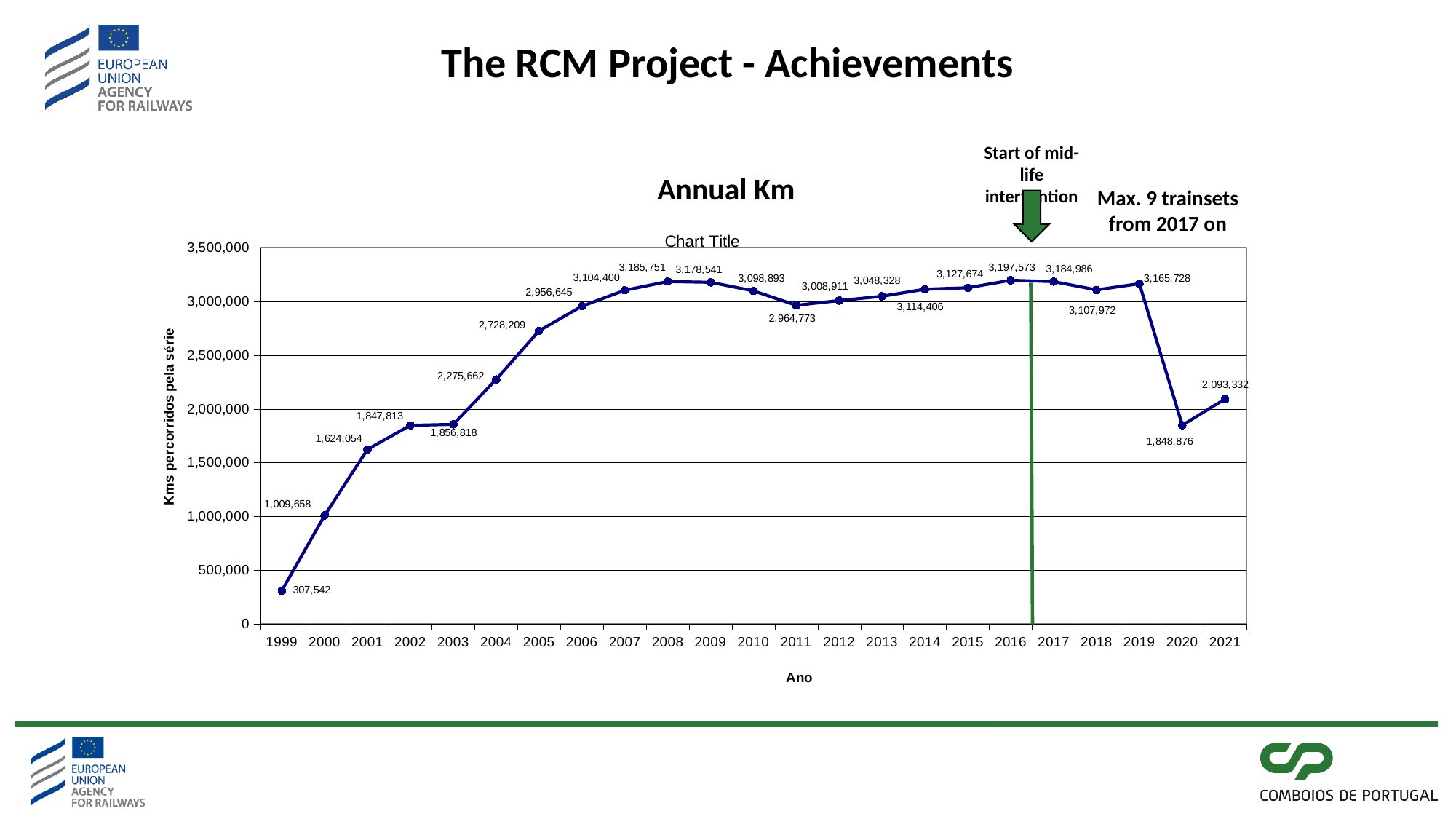
What is the label of the y axis of the chart? Kms percorridos pela série What is the difference between the values for 2021 and 2020? 244,456 Which year has the larger value, 2008 or 2009? 2008 Which year has the lowest value in the Annual Km chart? 1999 What type of chart is shown on the slide? Line chart What is the value for 2016 in the Annual Km chart? 3,197,573 Is the value for 2005 greater or less than 2,500,000? greater What is the value for 2021 in the Annual Km chart? 2,093,332 What is the value for 1999 in the Annual Km chart? 307,542 How many years are plotted on the x axis of the chart? 23 Which year has the highest value in the Annual Km chart? 2016 What is the value for 2020 in the Annual Km chart? 1,848,876